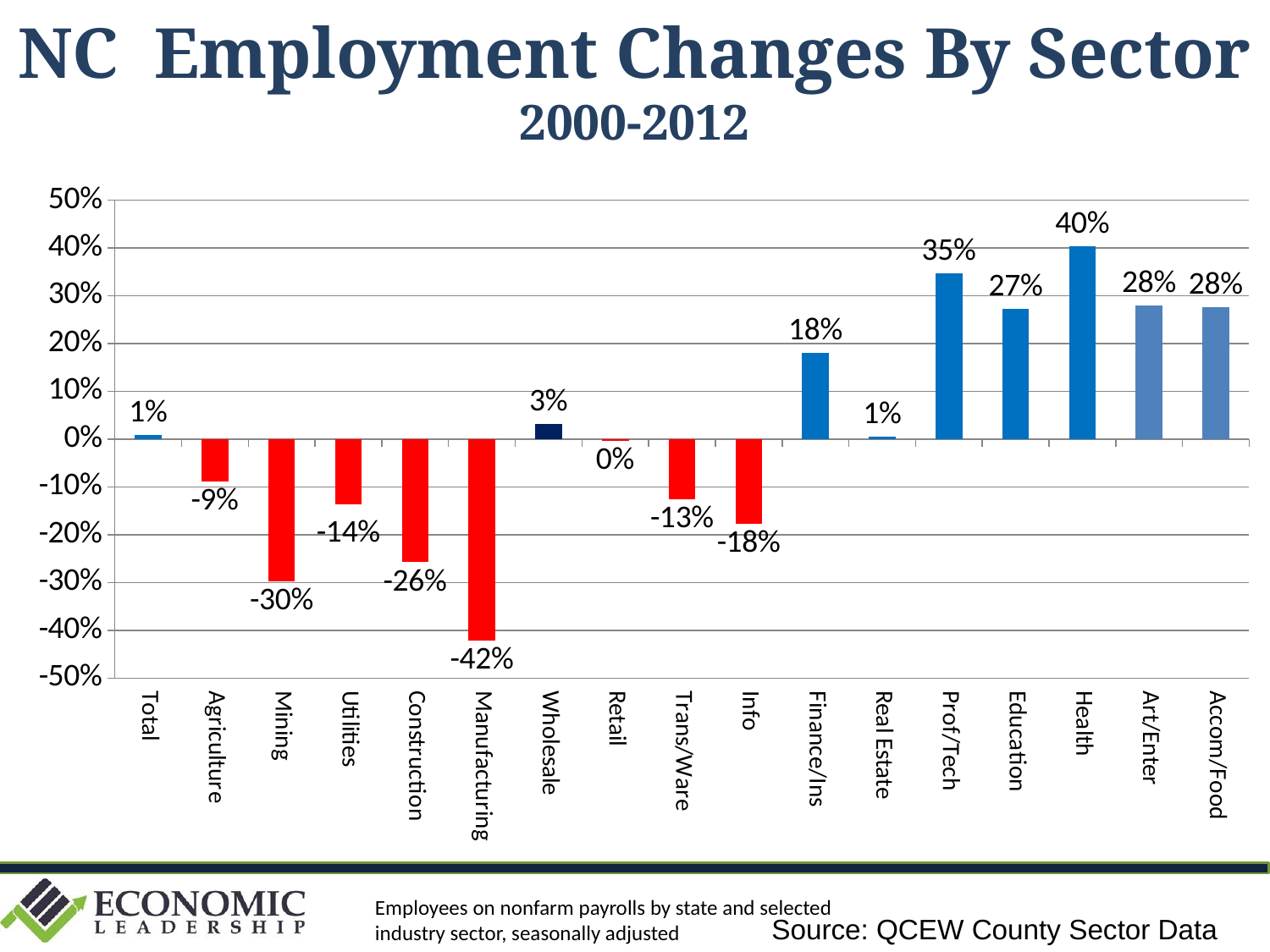
What is the employment change for Mining? -30% What is the employment change for Health? 40% Which sector has the lowest employment change? Manufacturing What is the employment change for Manufacturing? -42% What kind of chart is shown on the slide? Bar chart What colour are the bars for sectors with negative employment change? Red Which sector has the highest employment change? Health What is the title of the chart on the slide? NC Employment Changes By Sector 2000-2012 What is the employment change for Finance/Ins? 18% How many sectors are shown on the x axis? 17 What is the difference between the employment change for Prof/Tech and Education? 8%